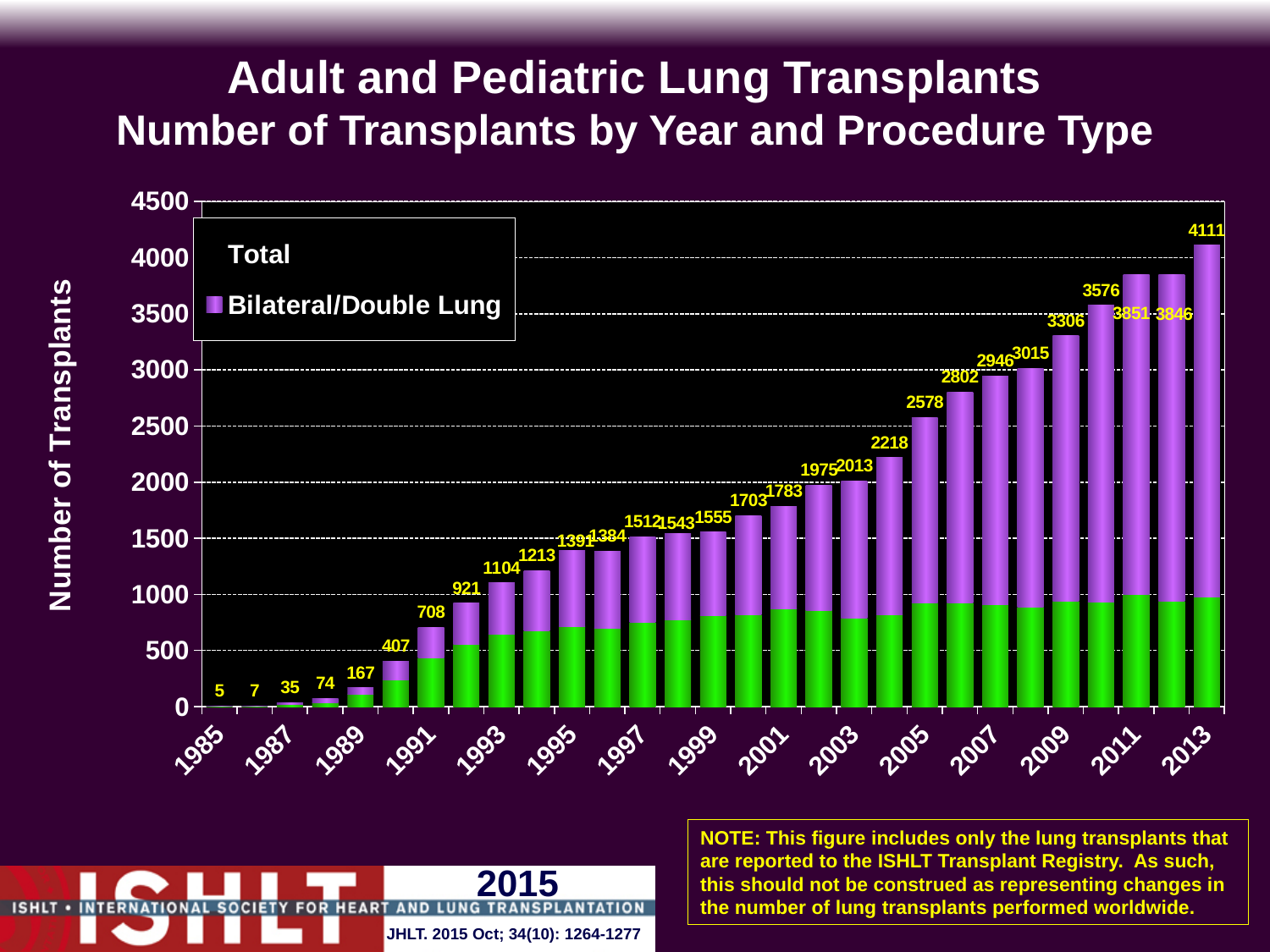
What value is labeled on the bar for 2013? 4111 What kind of chart is shown on the slide? Stacked bar chart Do the labeled values generally rise or fall from 1985 to 2013? Rise What is the title of the vertical axis? Number of Transplants How many series does the legend list? 2 Which year has the highest labeled value? 2013 Which year has the larger labeled value, 1995 or 1996? 1995 Which year has the lowest labeled value? 1985 What is the difference between the labeled values for 2013 and 2012? 265 What value is labeled on the bar for 1990? 407 How many years (bars) are plotted on the chart? 29 What value is labeled on the bar for 2005? 2578